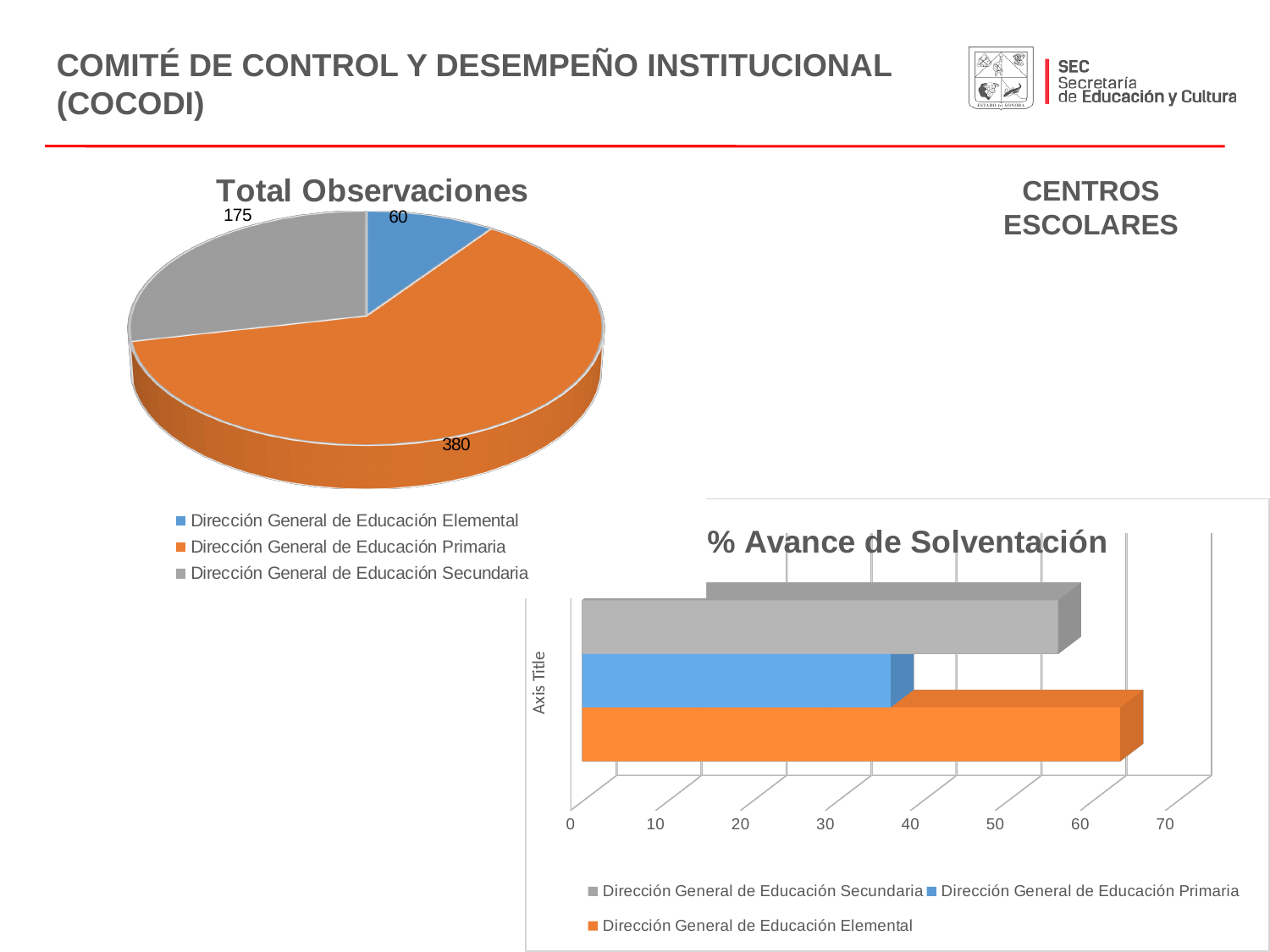
In the % Avance de Solventación chart, is the value for Dirección General de Educación Primaria greater or less than 40? less In the % Avance de Solventación chart, is the value for Dirección General de Educación Elemental greater or less than 60? greater In the Total Observaciones pie chart, which category has the smallest slice? Dirección General de Educación Elemental In the Total Observaciones pie chart, what is the value for Dirección General de Educación Primaria? 380 In the Total Observaciones pie chart, what is the value for Dirección General de Educación Secundaria? 175 How many entries does the legend of the % Avance de Solventación chart list? 3 What kind of chart is the % Avance de Solventación chart? Bar chart In the Total Observaciones pie chart, what is the difference between the values for Primaria and Secundaria? 205 In the Total Observaciones pie chart, what is the total of all three slices? 615 In the Total Observaciones pie chart, which category has the largest slice? Dirección General de Educación Primaria In the Total Observaciones pie chart, what is the value for Dirección General de Educación Elemental? 60 In the % Avance de Solventación chart, which category has the longest bar? Dirección General de Educación Elemental